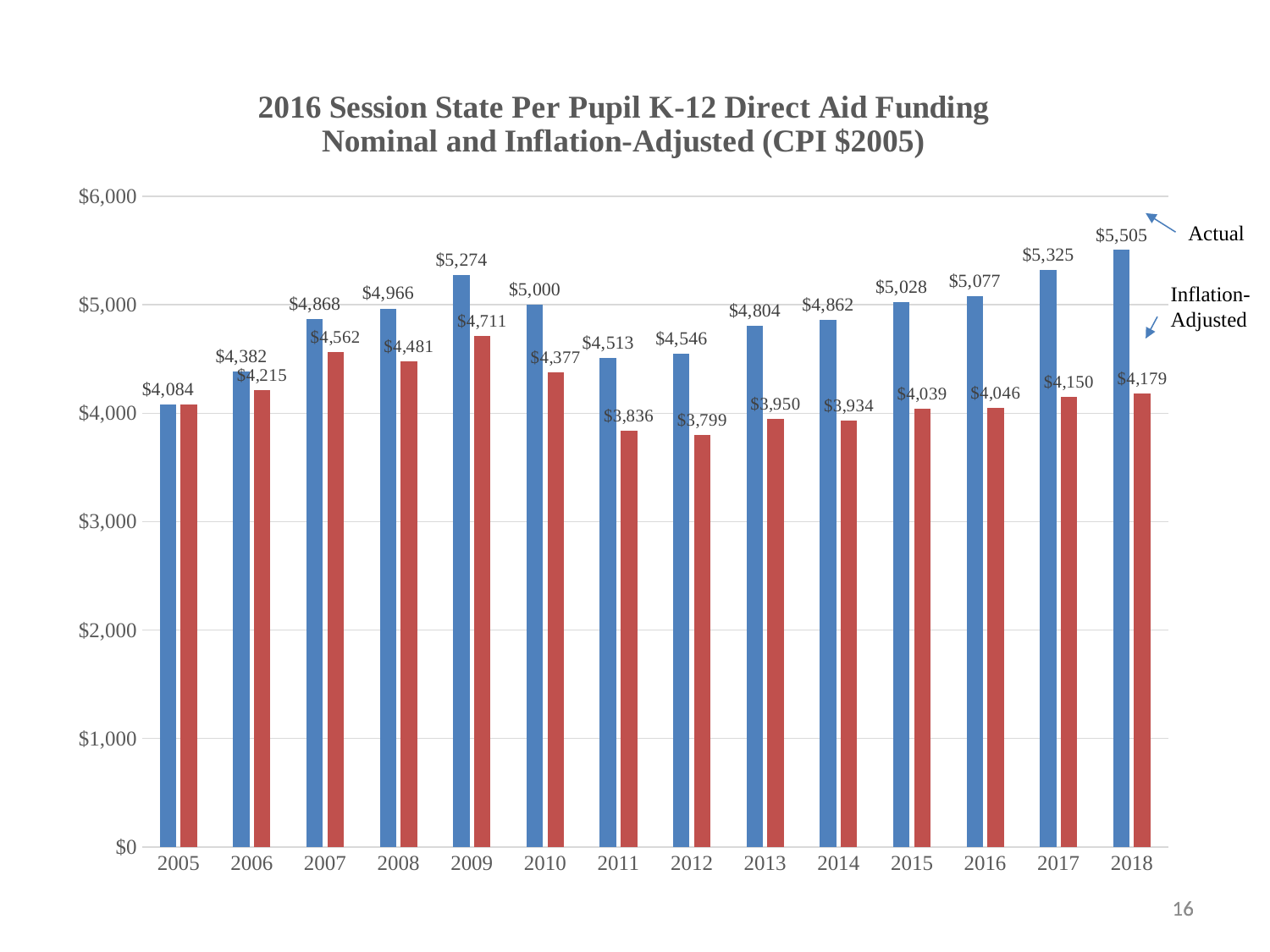
What is the Inflation-Adjusted value for 2012? $3,799 Which series is shown in blue? Actual How many series does the chart show? 2 What is the difference between the Actual and Inflation-Adjusted values for 2018? $1,326 Which year has the larger Actual value, 2010 or 2013? 2010 What is the Actual value for 2014? $4,862 Which year has the lowest Inflation-Adjusted value? 2012 What is the Actual value for 2009? $5,274 How many years are shown on the x axis? 14 Which year has the highest Actual value? 2018 What kind of chart is shown on the slide? bar chart Is the Actual value for 2017 greater or less than $5,000? greater